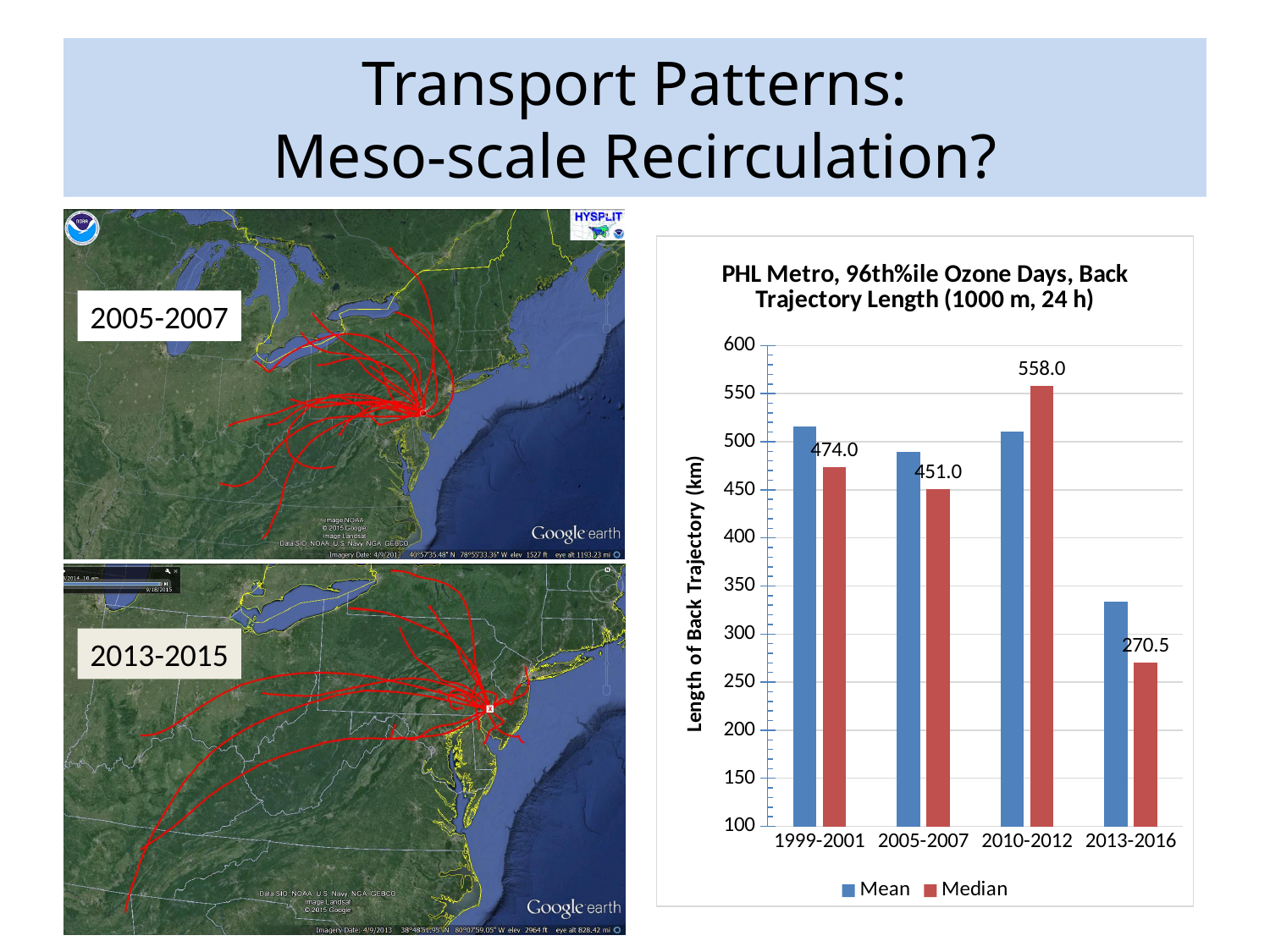
Which period has the lowest Median back trajectory length? 2013-2016 What is the difference between the Median values for 1999-2001 and 2005-2007? 23.0 Which period has the highest Median back trajectory length? 2010-2012 Is the Mean value for 2013-2016 greater or less than 350? less What is the Median value shown for 2013-2016? 270.5 What is the difference between the Median values for 2010-2012 and 2005-2007? 107.0 What type of chart is used to show the back trajectory lengths? Bar chart How many time periods are shown on the x axis of the chart? 4 For 2010-2012, which is larger, the Mean or the Median? Median Is the Mean value for 1999-2001 greater or less than 500? greater What is the Median back trajectory length for 1999-2001? 474.0 How many series does the chart legend list? 2